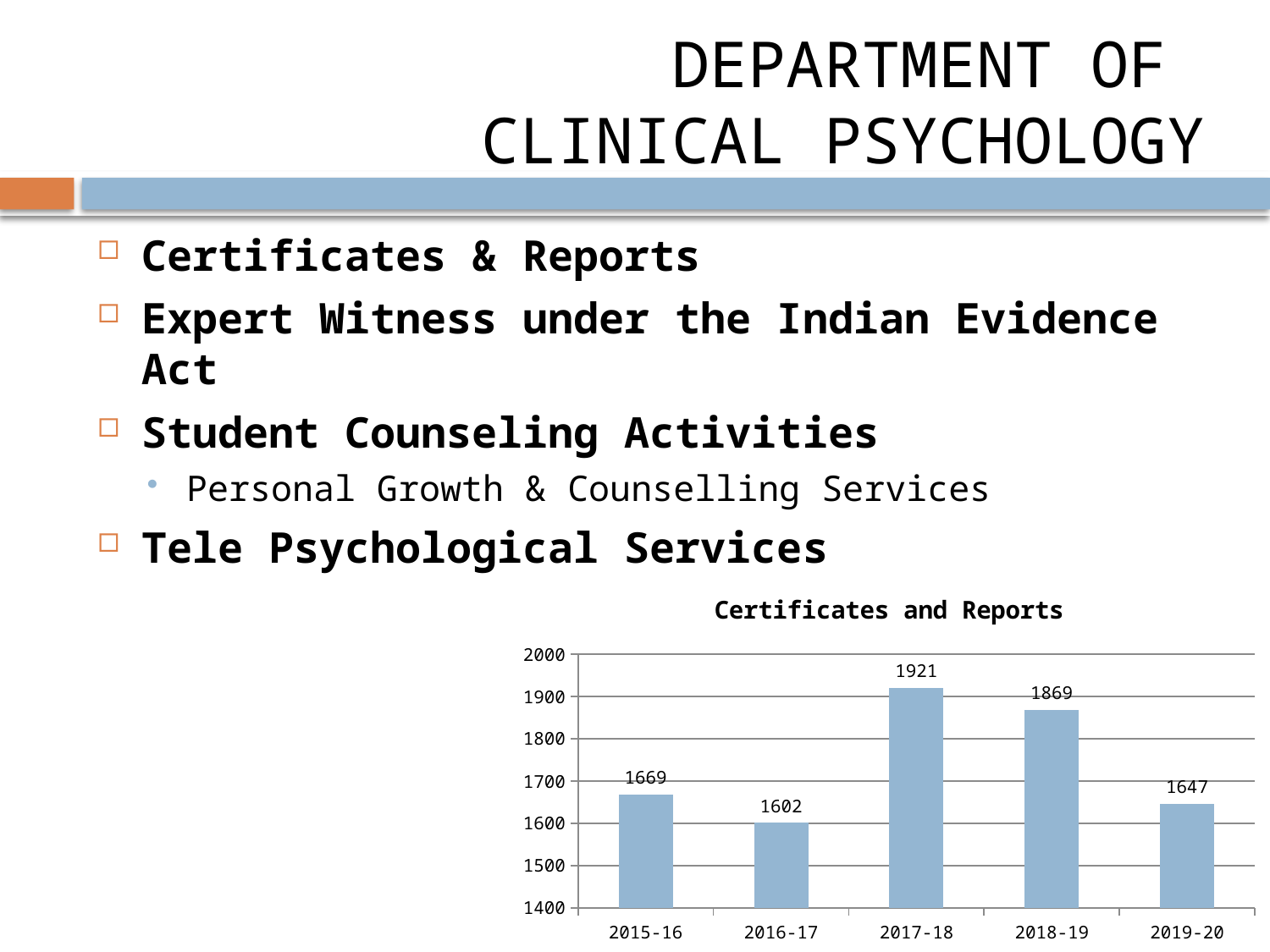
Which is larger in the Certificates and Reports chart, the value for 2015-16 or the value for 2019-20? 2015-16 Which year has the highest value in the Certificates and Reports chart? 2017-18 What kind of chart is the Certificates and Reports chart? bar chart Is the value for 2018-19 in the Certificates and Reports chart greater or less than 1800? greater What is the difference between the values for 2017-18 and 2018-19 in the Certificates and Reports chart? 52 How many years are shown in the Certificates and Reports chart? 5 What is the title of the chart on the slide? Certificates and Reports What is the value for 2017-18 in the Certificates and Reports chart? 1921 What is the difference between the values for 2015-16 and 2016-17 in the Certificates and Reports chart? 67 What is the value for 2015-16 in the Certificates and Reports chart? 1669 What is the value for 2019-20 in the Certificates and Reports chart? 1647 Which year has the lowest value in the Certificates and Reports chart? 2016-17